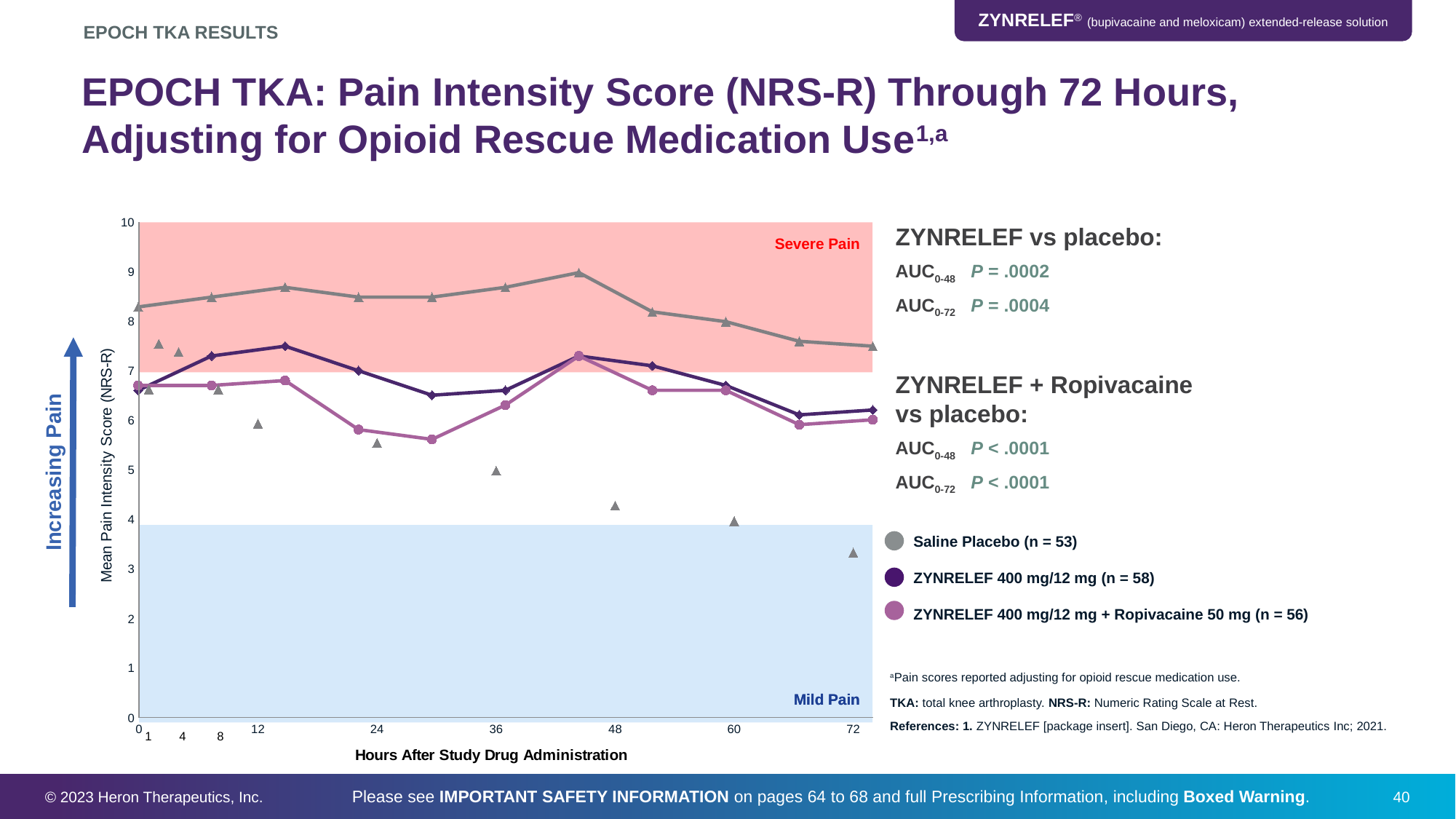
Is the ZYNRELEF 400 mg/12 mg + Ropivacaine 50 mg value at 24 hours greater or less than 6? less What kind of chart is shown on the slide? Line chart What is the P value for AUC0-48 for ZYNRELEF vs placebo? P = .0002 Is the ZYNRELEF 400 mg/12 mg value at 72 hours greater or less than 7? less Is the Saline Placebo value at 36 hours greater or less than 8? greater Does the Saline Placebo line rise or fall between 48 and 72 hours? Fall Which series has the lowest mean pain intensity score at 24 hours? ZYNRELEF 400 mg/12 mg + Ropivacaine 50 mg (n = 56) At 24 hours, which is larger: the Saline Placebo value or the ZYNRELEF 400 mg/12 mg + Ropivacaine 50 mg value? Saline Placebo Which series has the highest mean pain intensity score across the 72 hours? Saline Placebo (n = 53) How many series does the legend list? 3 What is the label of the x axis? Hours After Study Drug Administration